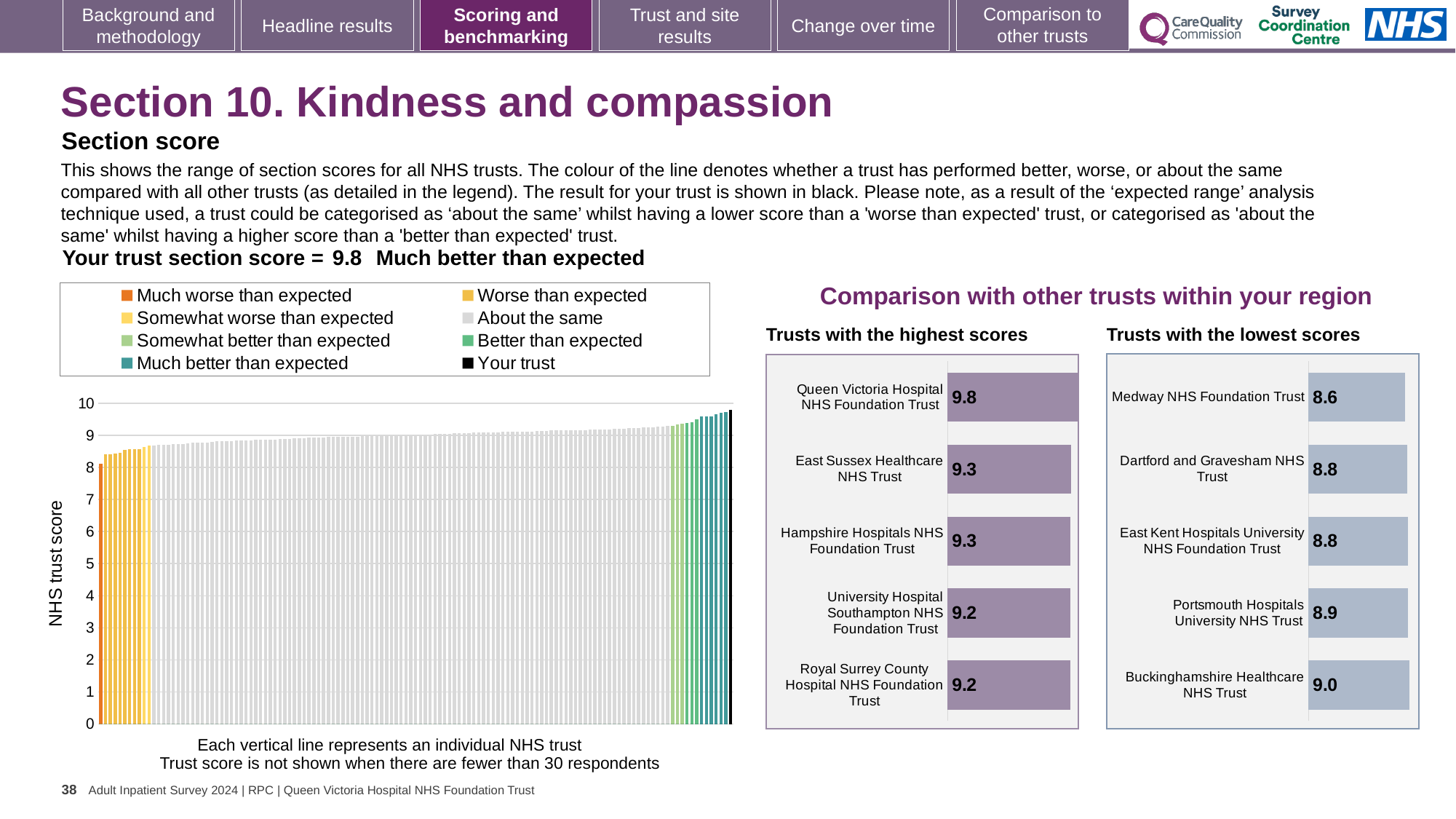
What kind of chart is the NHS trust score chart on the left of the slide? Bar chart In the 'Trusts with the highest scores' chart, what is the score for Queen Victoria Hospital NHS Foundation Trust? 9.8 How many entries does the legend of the NHS trust score chart on the left list? 8 In the NHS trust score chart on the left, do the bar values rise or fall from left to right? Rise In the 'Trusts with the highest scores' chart, which trust has the highest score? Queen Victoria Hospital NHS Foundation Trust In the 'Trusts with the lowest scores' chart, which has the larger score: Portsmouth Hospitals University NHS Trust or Dartford and Gravesham NHS Trust? Portsmouth Hospitals University NHS Trust In the 'Trusts with the lowest scores' chart, what is the score for Medway NHS Foundation Trust? 8.6 How many trusts are listed in the 'Trusts with the highest scores' chart? 5 In the 'Trusts with the lowest scores' chart, which trust has the lowest score? Medway NHS Foundation Trust In the 'Trusts with the highest scores' chart, what is the difference between the score for Queen Victoria Hospital NHS Foundation Trust and the score for Royal Surrey County Hospital NHS Foundation Trust? 0.6 In the 'Trusts with the lowest scores' chart, what is the difference between the score for Buckinghamshire Healthcare NHS Trust and the score for Medway NHS Foundation Trust? 0.4 How many trusts are listed in the 'Trusts with the lowest scores' chart? 5